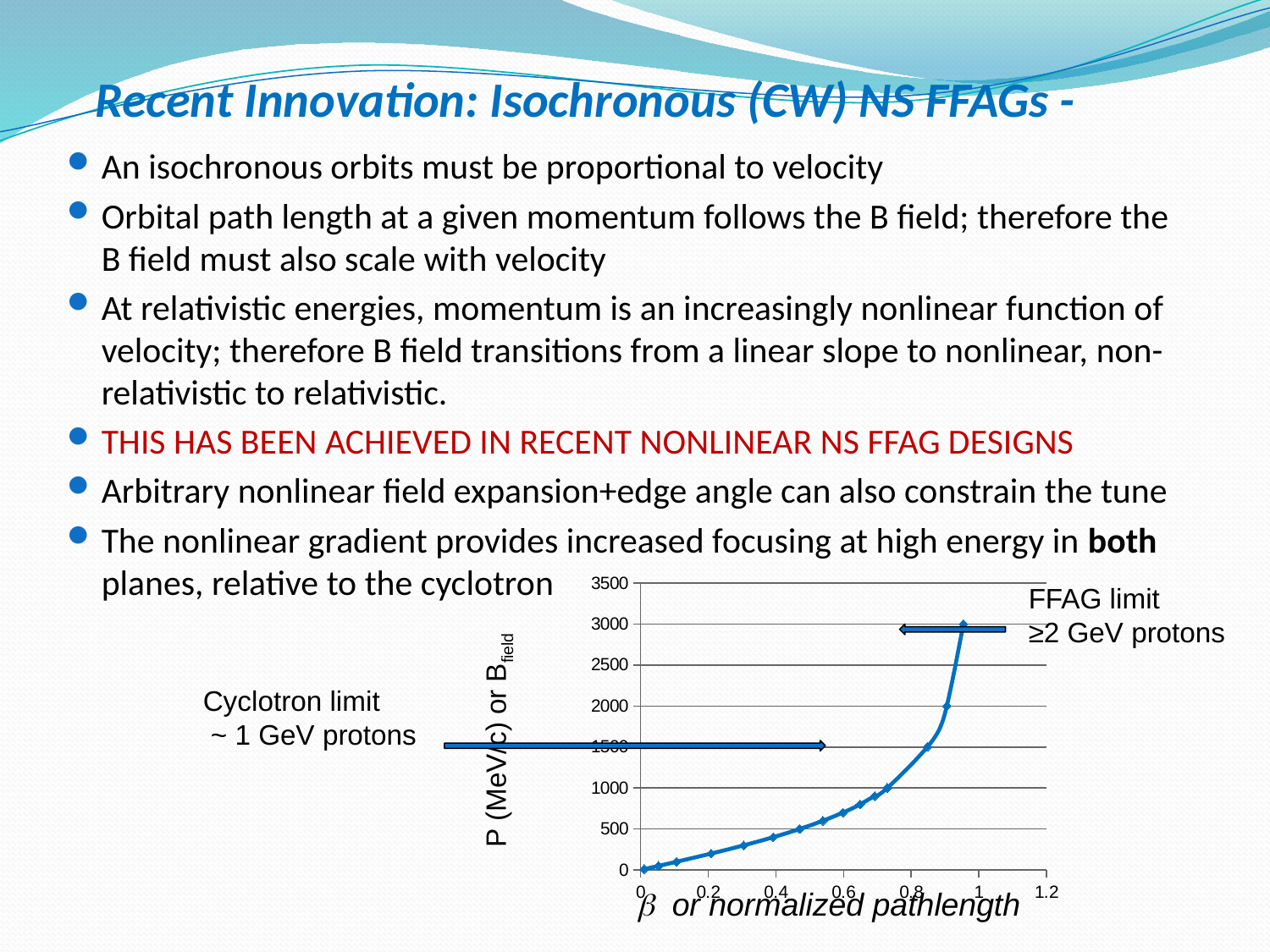
What is the highest tick value shown on the y axis? 3500 What kind of chart is shown on the slide? line chart What is the label of the x axis? β or normalized pathlength Is the plotted value of P at β = 0.2 greater or less than 500? less Is the plotted value of P at β = 0.9 greater or less than 1500? greater Do the plotted values rise or fall as β increases along the x axis? rise Is the plotted value of P at β = 0.4 greater or less than 1000? less